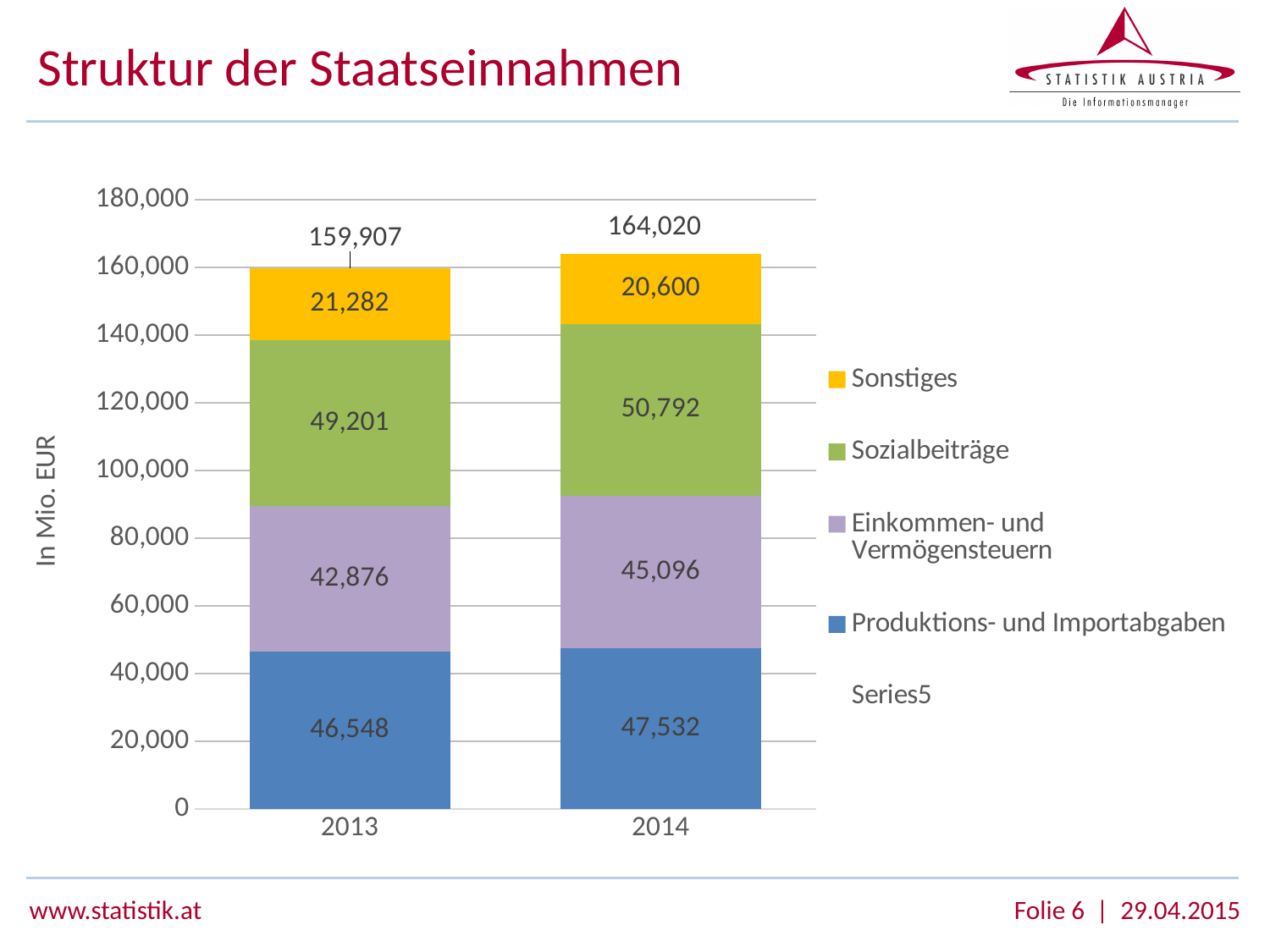
Is the value for Sonstiges larger in 2013 or in 2014? 2013 What is the difference between the 2014 total and the 2013 total? 4,113 What is the total of the stacked bar for 2013? 159,907 What type of chart is shown on the slide? Stacked bar chart What is the value for Sozialbeiträge in 2014? 50,792 Which series has the largest value in 2014? Sozialbeiträge What is the total of the stacked bar for 2014? 164,020 How many entries does the legend list? 5 What is the value for Sonstiges in 2013? 21,282 What is the value for Produktions- und Importabgaben in 2013? 46,548 By how much did Sozialbeiträge increase from 2013 to 2014? 1,591 What is the value for Einkommen- und Vermögensteuern in 2014? 45,096